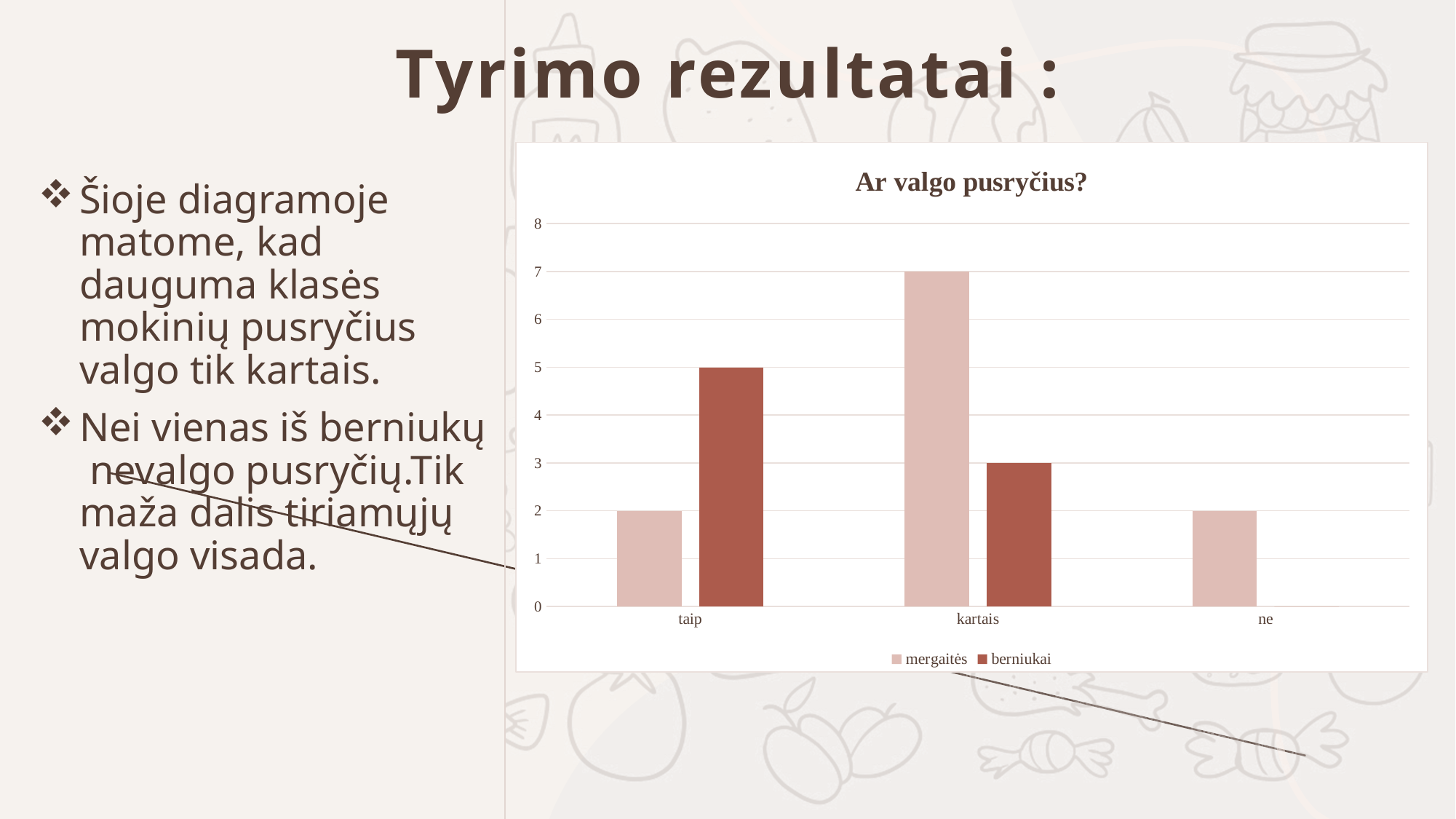
How many series does the legend list? 2 What is the value for berniukai in the kartais category? 3 What is the value for berniukai in the taip category? 5 What is the title of the chart? Ar valgo pusryčius? What is the difference between the mergaitės and berniukai values in the kartais category? 4 Which category has the lowest value for berniukai? ne Which category has the highest value for mergaitės? kartais What kind of chart is shown on the slide? bar chart What is the value for mergaitės in the kartais category? 7 In the taip category, which series has the larger value, mergaitės or berniukai? berniukai How many categories are shown on the x axis? 3 What is the value for mergaitės in the ne category? 2